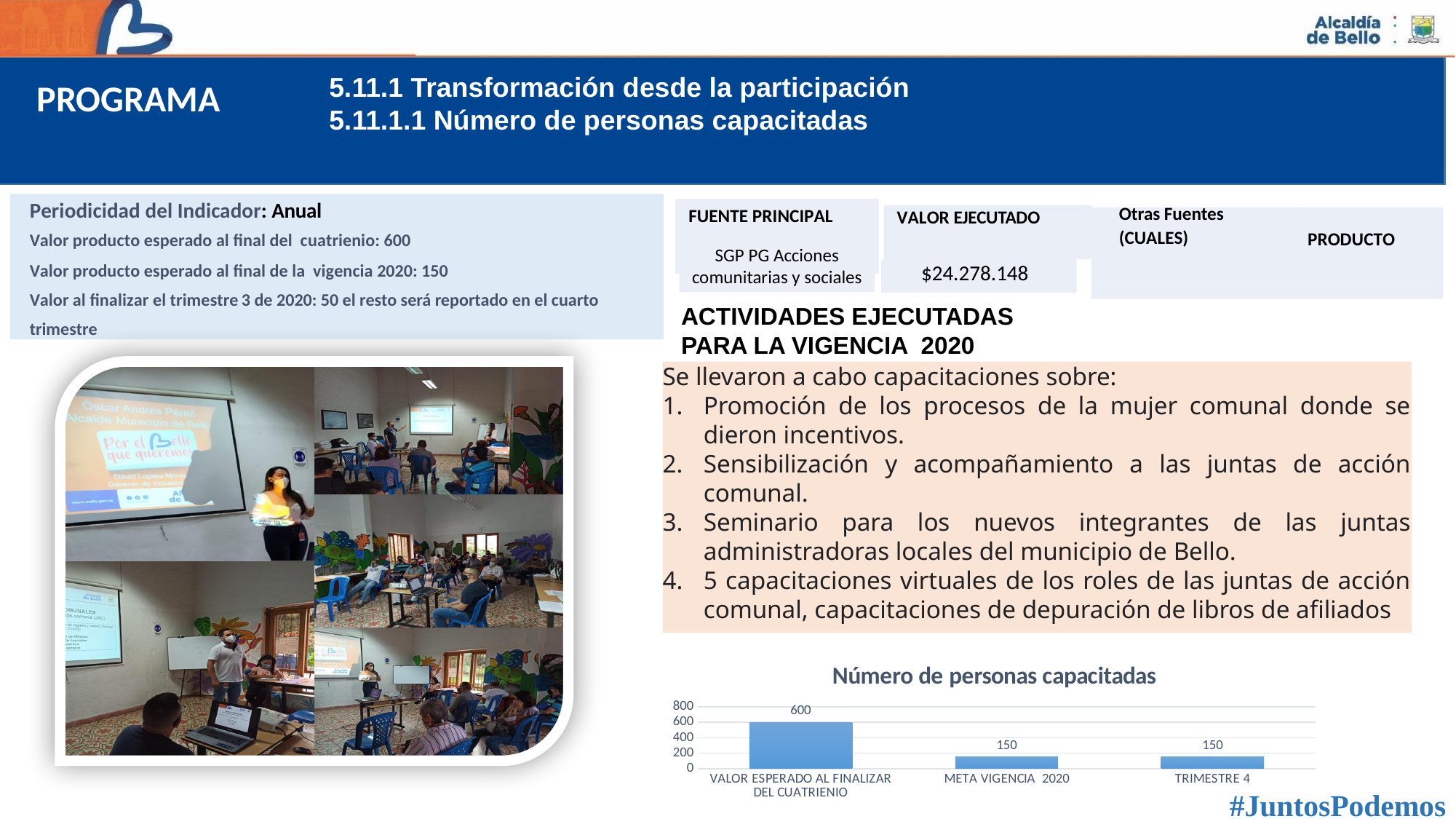
What is the title of the chart? Número de personas capacitadas What is the highest value shown on the y axis of the chart? 800 What type of chart is shown on the slide? bar chart Which category has the highest value? VALOR ESPERADO AL FINALIZAR DEL CUATRIENIO What is the difference between the value for VALOR ESPERADO AL FINALIZAR DEL CUATRIENIO and the value for META VIGENCIA 2020? 450 What is the value for META VIGENCIA 2020? 150 Which is larger, the value for VALOR ESPERADO AL FINALIZAR DEL CUATRIENIO or the value for TRIMESTRE 4? VALOR ESPERADO AL FINALIZAR DEL CUATRIENIO Is the value for VALOR ESPERADO AL FINALIZAR DEL CUATRIENIO greater or less than 400? greater What is the value for VALOR ESPERADO AL FINALIZAR DEL CUATRIENIO? 600 What is the value for TRIMESTRE 4? 150 Is the value for META VIGENCIA 2020 greater or less than 400? less How many categories are shown in the chart? 3